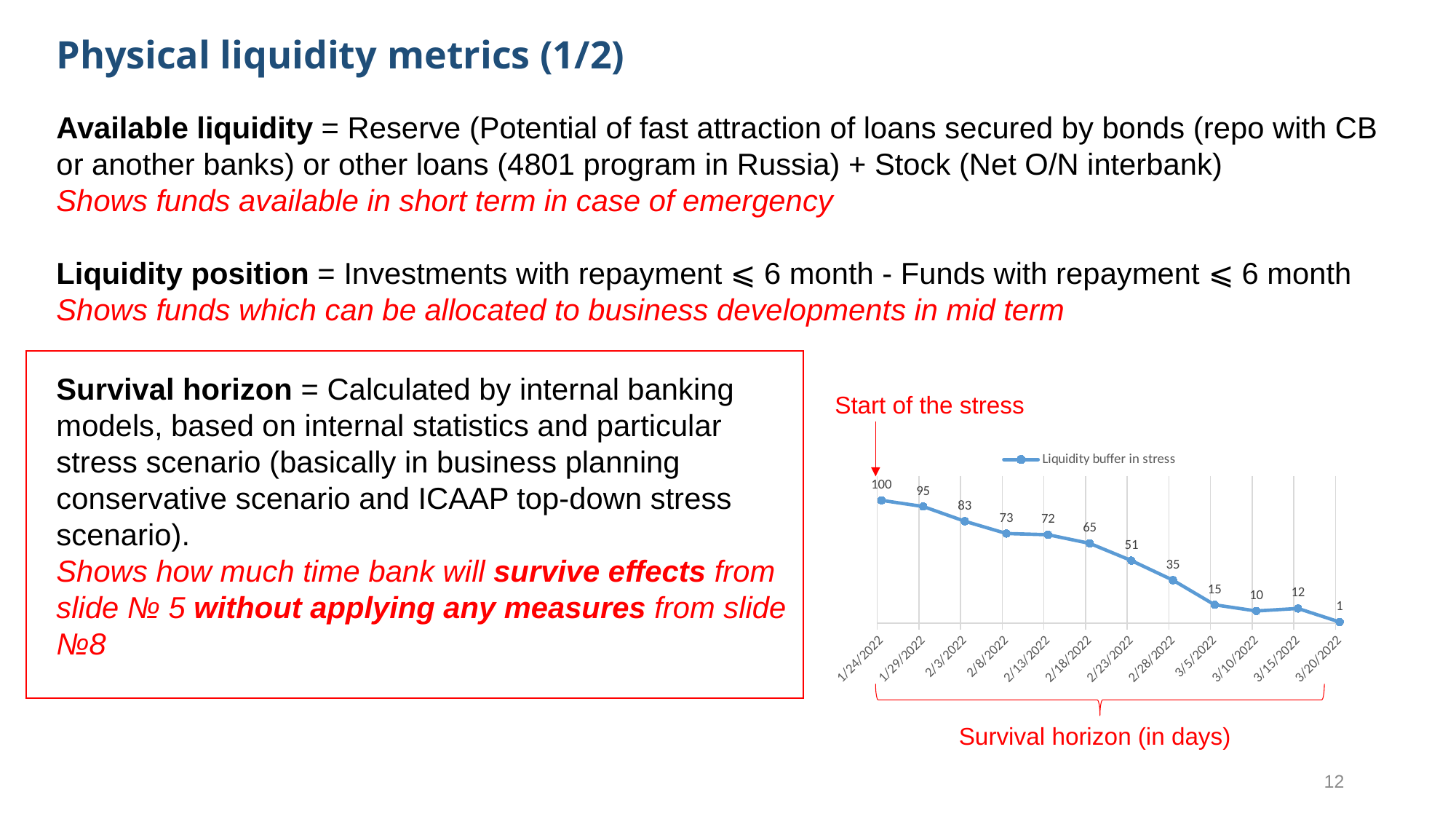
What is the value of the liquidity buffer in stress on 2/23/2022? 51 What is the difference between the liquidity buffer values on 2/18/2022 and 2/28/2022? 30 Does the liquidity buffer in stress generally rise or fall over the dates shown? fall What type of chart is shown on the slide? line chart On which date is the liquidity buffer in stress at its highest? 1/24/2022 Which date has a larger liquidity buffer value, 3/10/2022 or 3/15/2022? 3/15/2022 What is the name of the series shown in the chart legend? Liquidity buffer in stress How many series does the chart legend list? 1 What is the value of the liquidity buffer in stress on 3/20/2022? 1 On which date is the liquidity buffer in stress at its lowest? 3/20/2022 What is the value of the liquidity buffer in stress on 1/24/2022? 100 How many data points are plotted on the line chart? 12